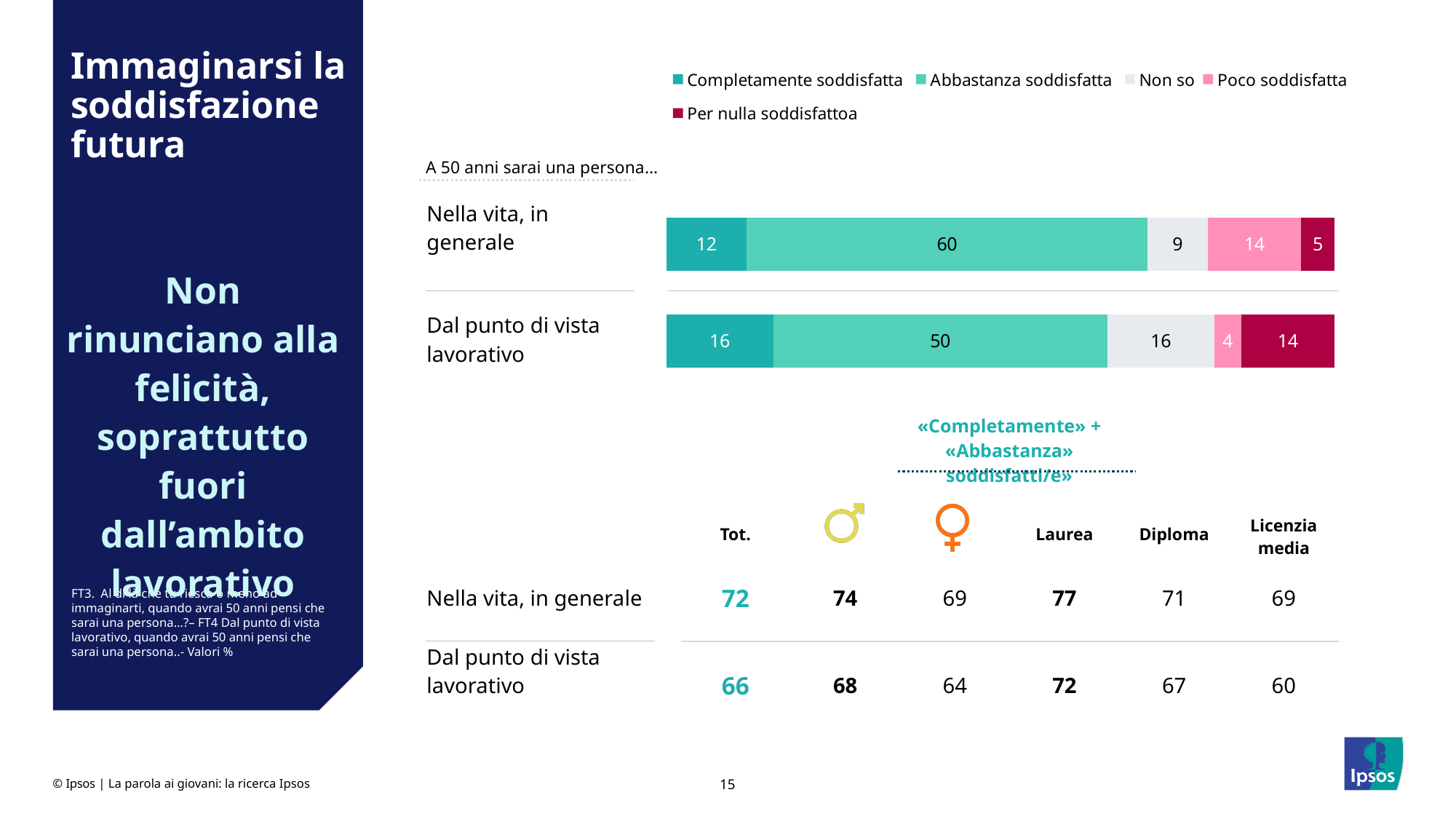
Which segment is the largest in the 'Dal punto di vista lavorativo' bar? Abbastanza soddisfatta What kind of chart is shown on the slide? stacked bar chart What is the value of 'Completamente soddisfatta' for 'Dal punto di vista lavorativo'? 16 What is the value of 'Non so' for 'Nella vita, in generale'? 9 What is the value of 'Per nulla soddisfattoa' for 'Dal punto di vista lavorativo'? 14 How many categories (bars) does the stacked bar chart show? 2 How many series does the chart legend list? 5 What is the total of the 'Nella vita, in generale' stacked bar? 100 Which is larger: 'Poco soddisfatta' for 'Nella vita, in generale' or 'Poco soddisfatta' for 'Dal punto di vista lavorativo'? Nella vita, in generale What is the difference between the 'Abbastanza soddisfatta' values for 'Nella vita, in generale' and 'Dal punto di vista lavorativo'? 10 What is the value of 'Abbastanza soddisfatta' for 'Nella vita, in generale'? 60 Which segment is the smallest in the 'Nella vita, in generale' bar? Per nulla soddisfattoa